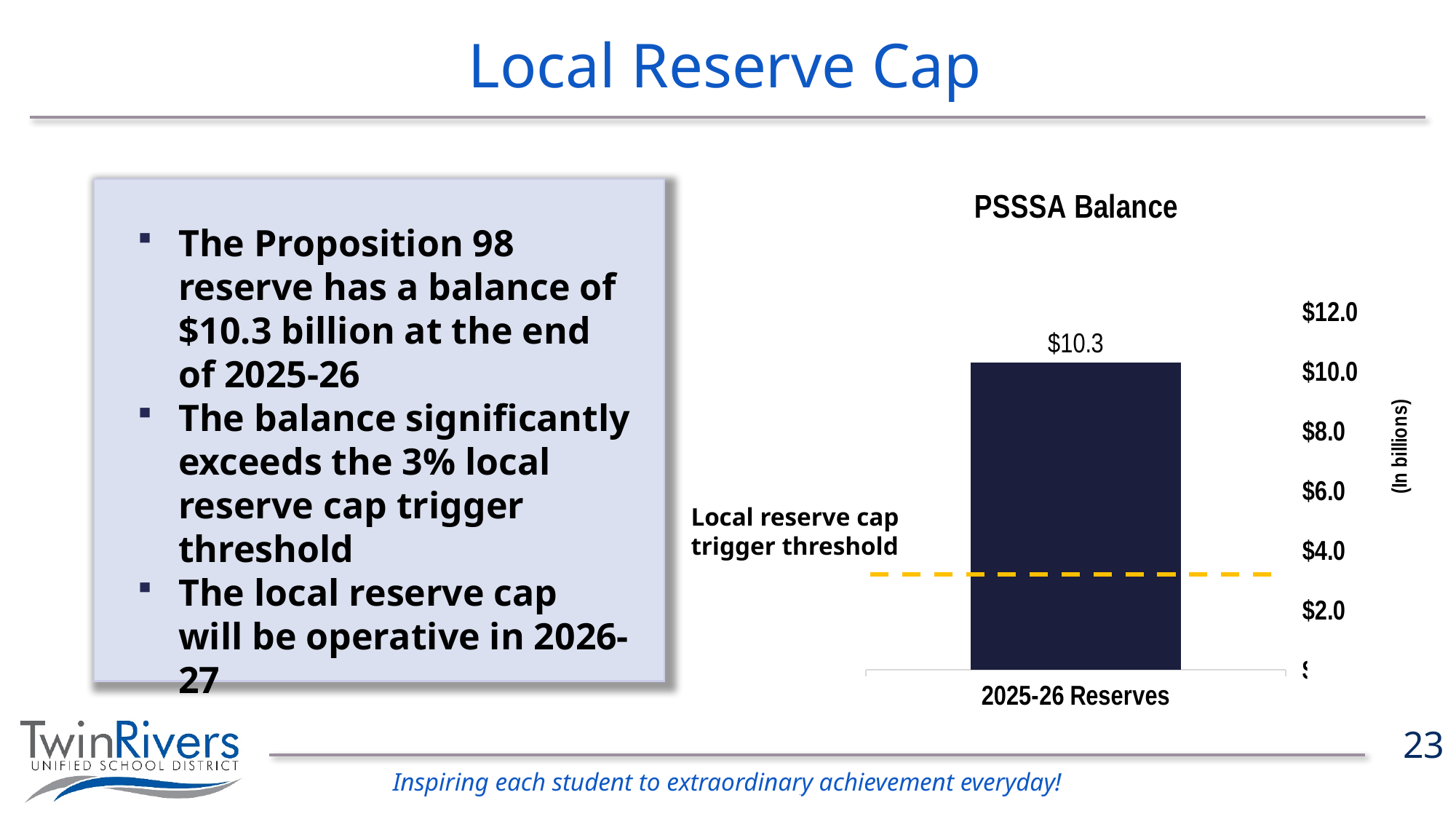
What does the dashed line in the PSSSA Balance chart represent? Local reserve cap trigger threshold Which is larger in the PSSSA Balance chart: the 2025-26 Reserves bar or the Local reserve cap trigger threshold line? 2025-26 Reserves bar What kind of chart is shown on the slide? Bar chart What is the title of the chart on the slide? PSSSA Balance Is the value for 2025-26 Reserves greater or less than $12.0? less What is the category label on the x axis of the PSSSA Balance chart? 2025-26 Reserves Is the Local reserve cap trigger threshold line greater or less than $4.0? less How many bars are plotted in the PSSSA Balance chart? 1 Is the value for 2025-26 Reserves greater or less than $8.0? greater What is the value shown for 2025-26 Reserves in the PSSSA Balance chart? $10.3